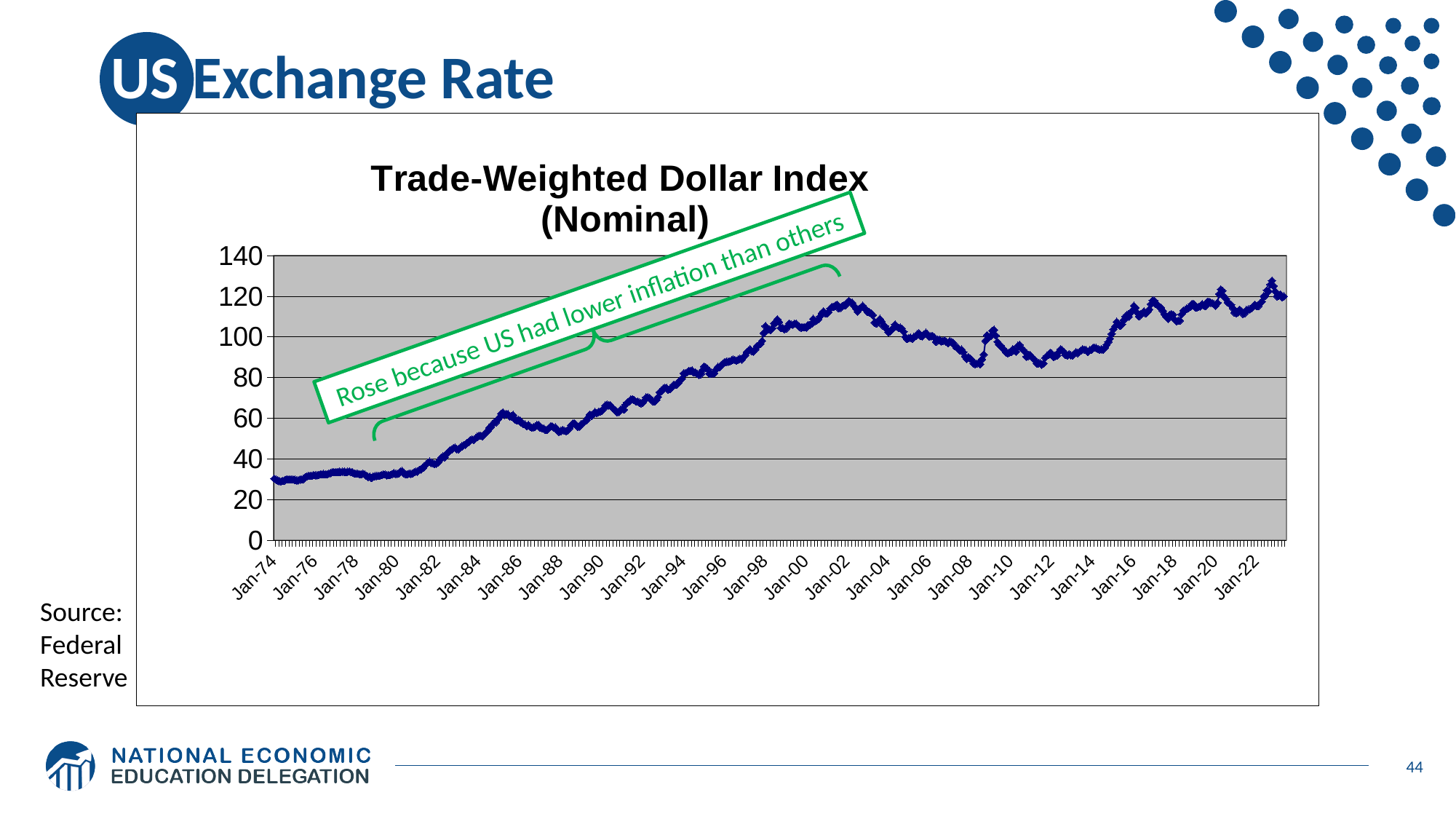
Is the value of the index at Jan-02 greater or less than 100? greater What does the green annotation on the chart say? Rose because US had lower inflation than others Is the value of the index at Jan-22 greater or less than 100? greater How many data series are plotted on the chart? 1 Is the value of the index at Jan-12 greater or less than 100? less What kind of chart is shown on the slide? line chart Which is larger, the index value at Jan-02 or at Jan-12? Jan-02 What is the title of the chart? Trade-Weighted Dollar Index (Nominal) Does the index rise or fall between Jan-74 and Jan-86? rise Does the index rise or fall between Jan-02 and Jan-08? fall